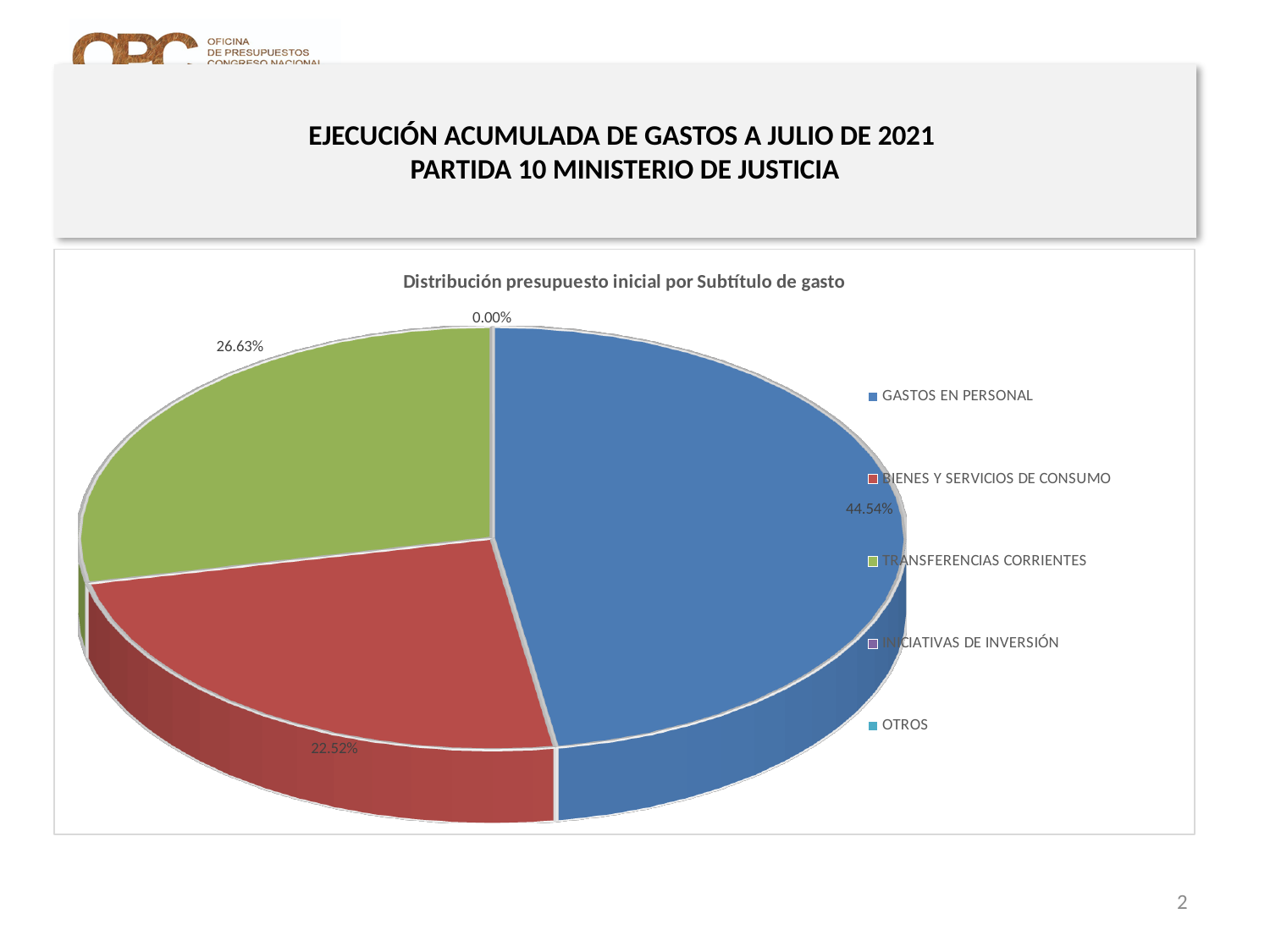
What kind of chart is shown on the slide? Pie chart What percentage does the TRANSFERENCIAS CORRIENTES slice represent? 26.63% What percentage does the GASTOS EN PERSONAL slice represent? 44.54% Which category has the largest share of the pie? GASTOS EN PERSONAL Which is larger, GASTOS EN PERSONAL or BIENES Y SERVICIOS DE CONSUMO? GASTOS EN PERSONAL How many categories does the legend list? 5 What percentage does the BIENES Y SERVICIOS DE CONSUMO slice represent? 22.52% What is the difference in percentage points between GASTOS EN PERSONAL and TRANSFERENCIAS CORRIENTES? 17.91 What is the difference in percentage points between TRANSFERENCIAS CORRIENTES and BIENES Y SERVICIOS DE CONSUMO? 4.11 Which is larger, TRANSFERENCIAS CORRIENTES or BIENES Y SERVICIOS DE CONSUMO? TRANSFERENCIAS CORRIENTES What is the title of the pie chart? Distribución presupuesto inicial por Subtítulo de gasto What colour is the GASTOS EN PERSONAL slice? Blue